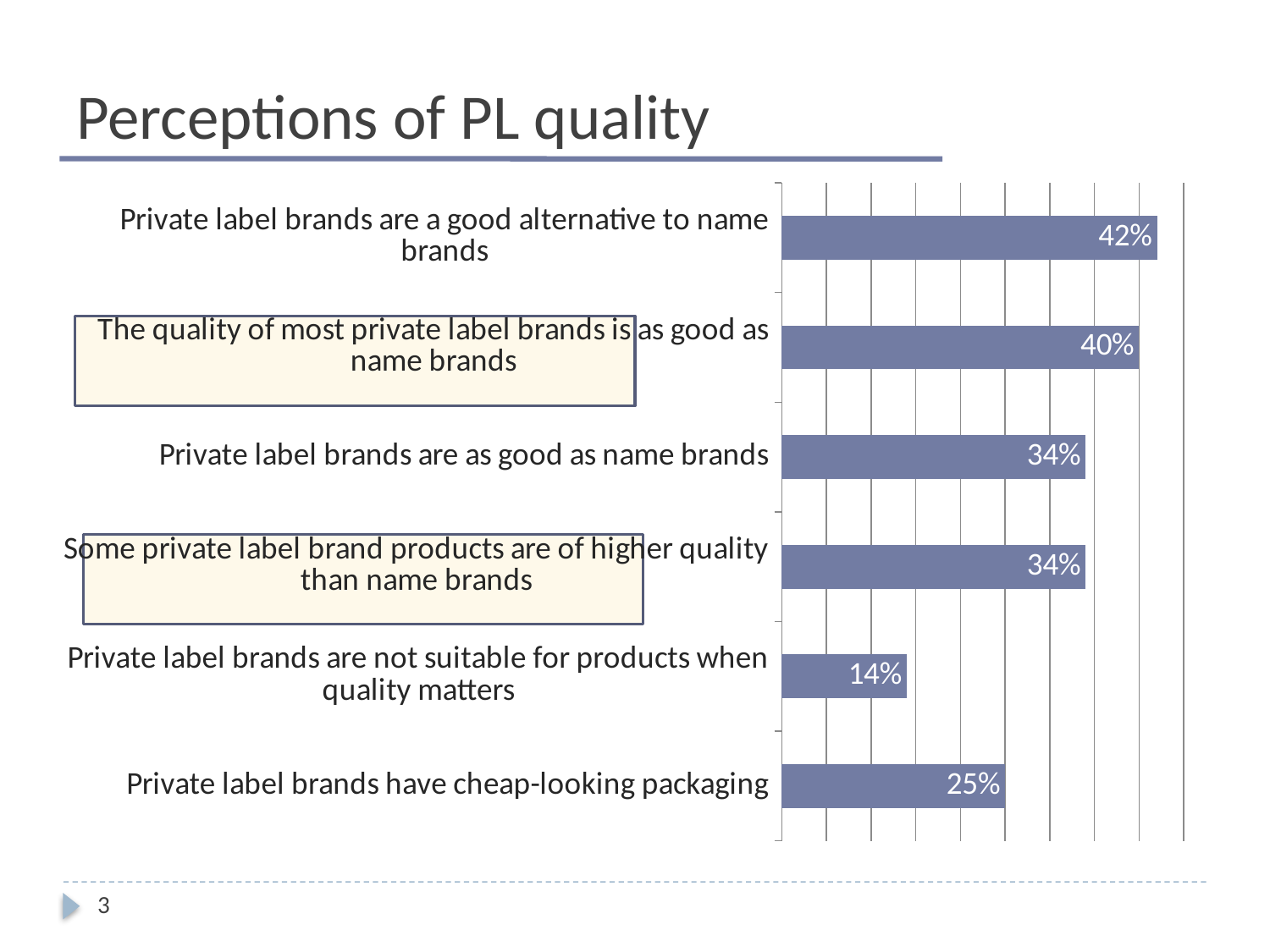
What is the value for 'Private label brands are not suitable for products when quality matters'? 14% Which statement has the lowest percentage? Private label brands are not suitable for products when quality matters Which two statements share the same value of 34%? Private label brands are as good as name brands; Some private label brand products are of higher quality than name brands What is the value for 'The quality of most private label brands is as good as name brands'? 40% Which is larger: the value for 'Private label brands have cheap-looking packaging' or the value for 'Private label brands are not suitable for products when quality matters'? Private label brands have cheap-looking packaging What is the value for 'Private label brands have cheap-looking packaging'? 25% Which statement has the highest percentage? Private label brands are a good alternative to name brands What is the title of the slide? Perceptions of PL quality What is the difference between the value for 'Private label brands are a good alternative to name brands' and the value for 'Private label brands have cheap-looking packaging'? 17% How many statements (categories) are shown in the chart? 6 What kind of chart is shown on the slide? Bar chart What percentage of respondents agree that private label brands are a good alternative to name brands? 42%